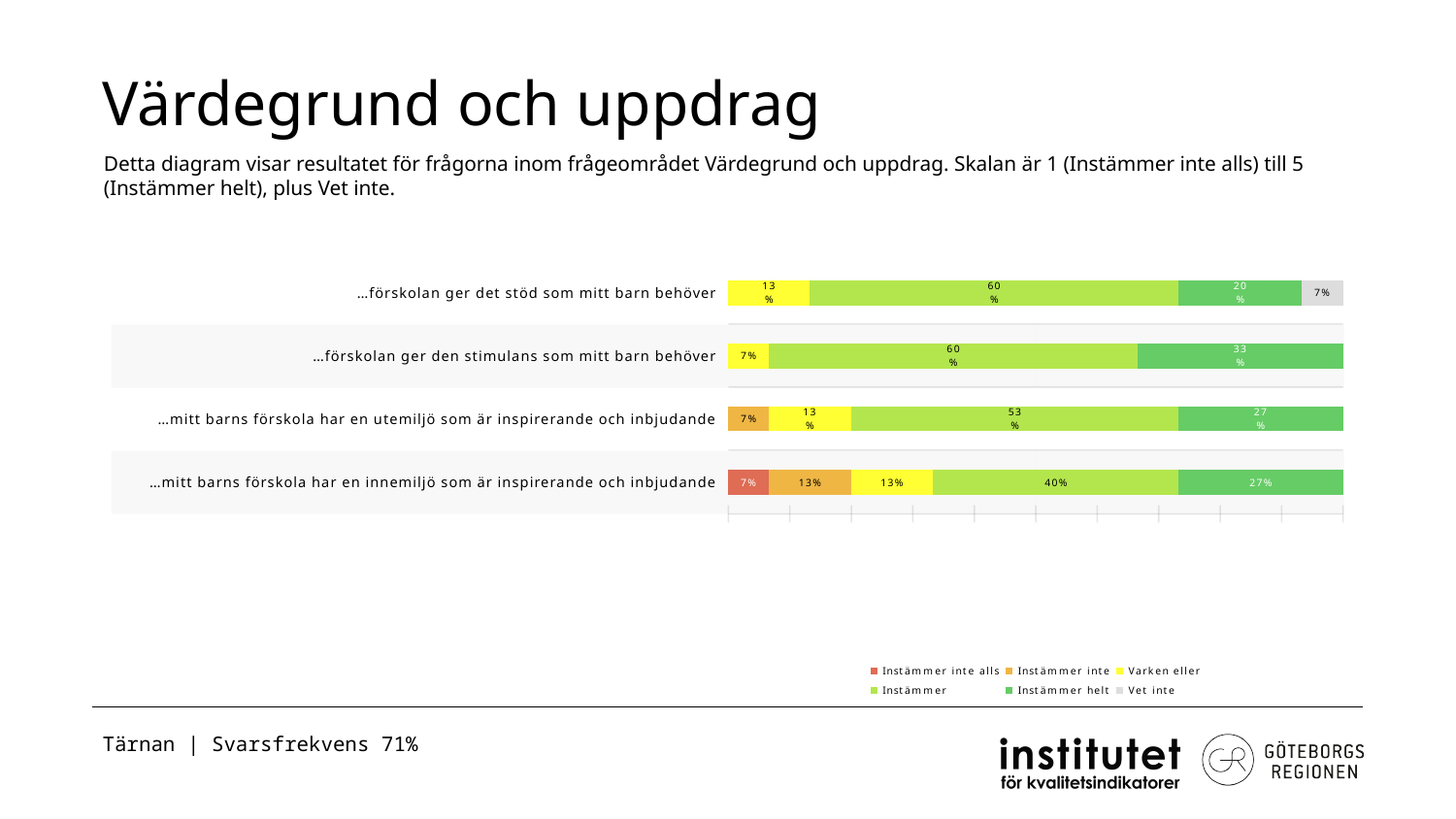
What is the 'Instämmer' value for '…förskolan ger det stöd som mitt barn behöver'? 60% What is the 'Instämmer' value for '…mitt barns förskola har en utemiljö som är inspirerande och inbjudande'? 53% What is the 'Instämmer inte alls' value for '…mitt barns förskola har en innemiljö som är inspirerande och inbjudande'? 7% What is the 'Vet inte' value for '…förskolan ger det stöd som mitt barn behöver'? 7% How many categories (statements) are plotted in the chart? 4 What is the difference between the 'Instämmer' values for '…förskolan ger det stöd som mitt barn behöver' and '…mitt barns förskola har en innemiljö som är inspirerande och inbjudande'? 20% Which statement has the highest 'Instämmer helt' value? …förskolan ger den stimulans som mitt barn behöver What type of chart is shown on the slide? Stacked bar chart Which is larger: the 'Instämmer helt' value for '…förskolan ger det stöd som mitt barn behöver' or for '…mitt barns förskola har en utemiljö som är inspirerande och inbjudande'? …mitt barns förskola har en utemiljö som är inspirerande och inbjudande What is the 'Instämmer helt' value for '…förskolan ger den stimulans som mitt barn behöver'? 33% How many series does the legend list? 6 Which statement has the lowest 'Instämmer' value? …mitt barns förskola har en innemiljö som är inspirerande och inbjudande